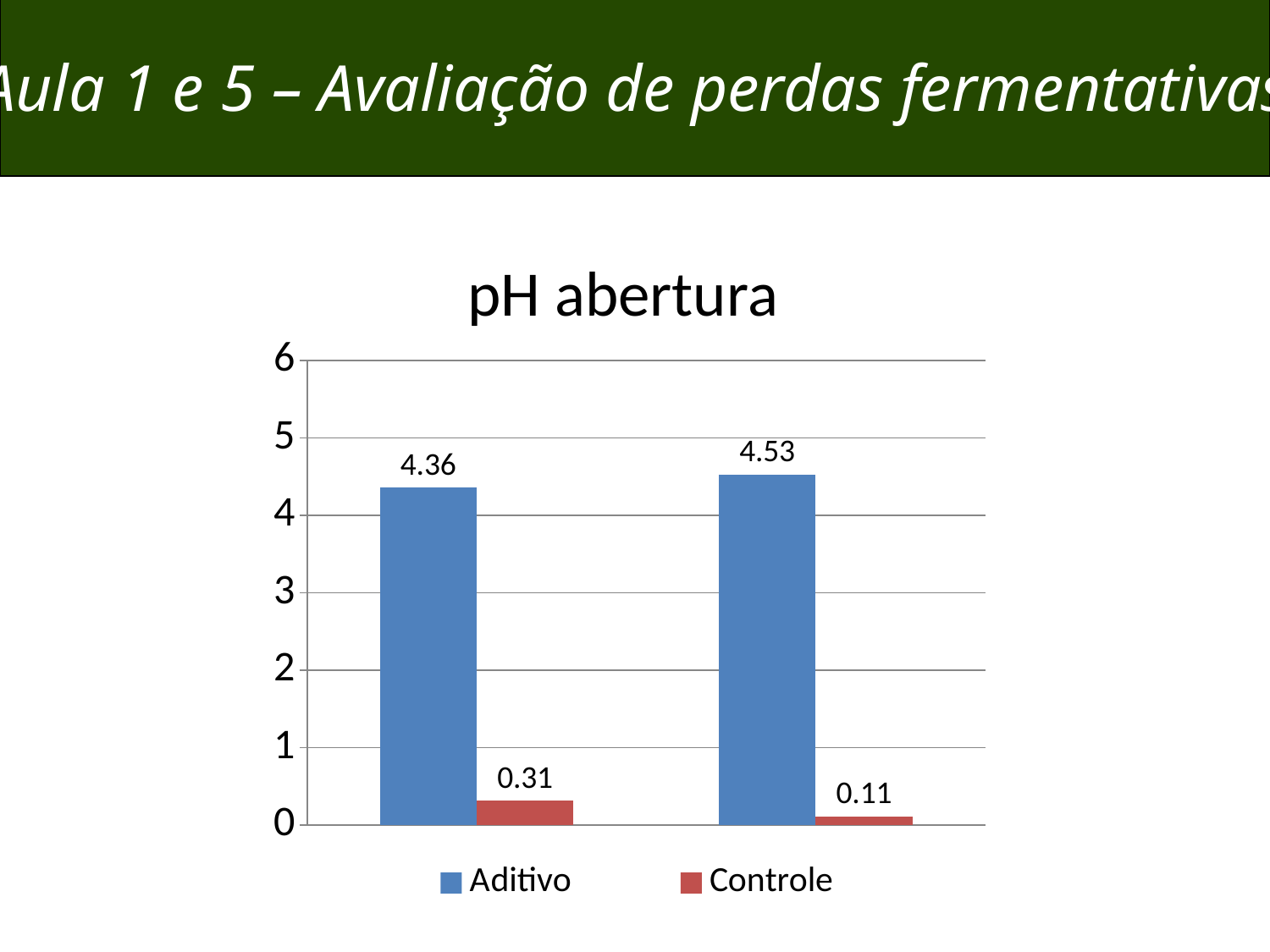
What is the value of the Controle bar in the right group? 0.11 What is the title of the chart? pH abertura Which series is shown in blue? Aditivo What is the difference between the Aditivo values in the right group and the left group? 0.17 What is the value of the Aditivo bar in the left group? 4.36 Which bar has the lowest value on the chart? Controle in the right group (0.11) Which bar has the highest value on the chart? Aditivo in the right group (4.53) What is the value of the Aditivo bar in the right group? 4.53 How many series does the legend list? 2 What is the value of the Controle bar in the left group? 0.31 Is the Controle value in the left group larger or smaller than the Controle value in the right group? larger What kind of chart is shown on the slide? bar chart